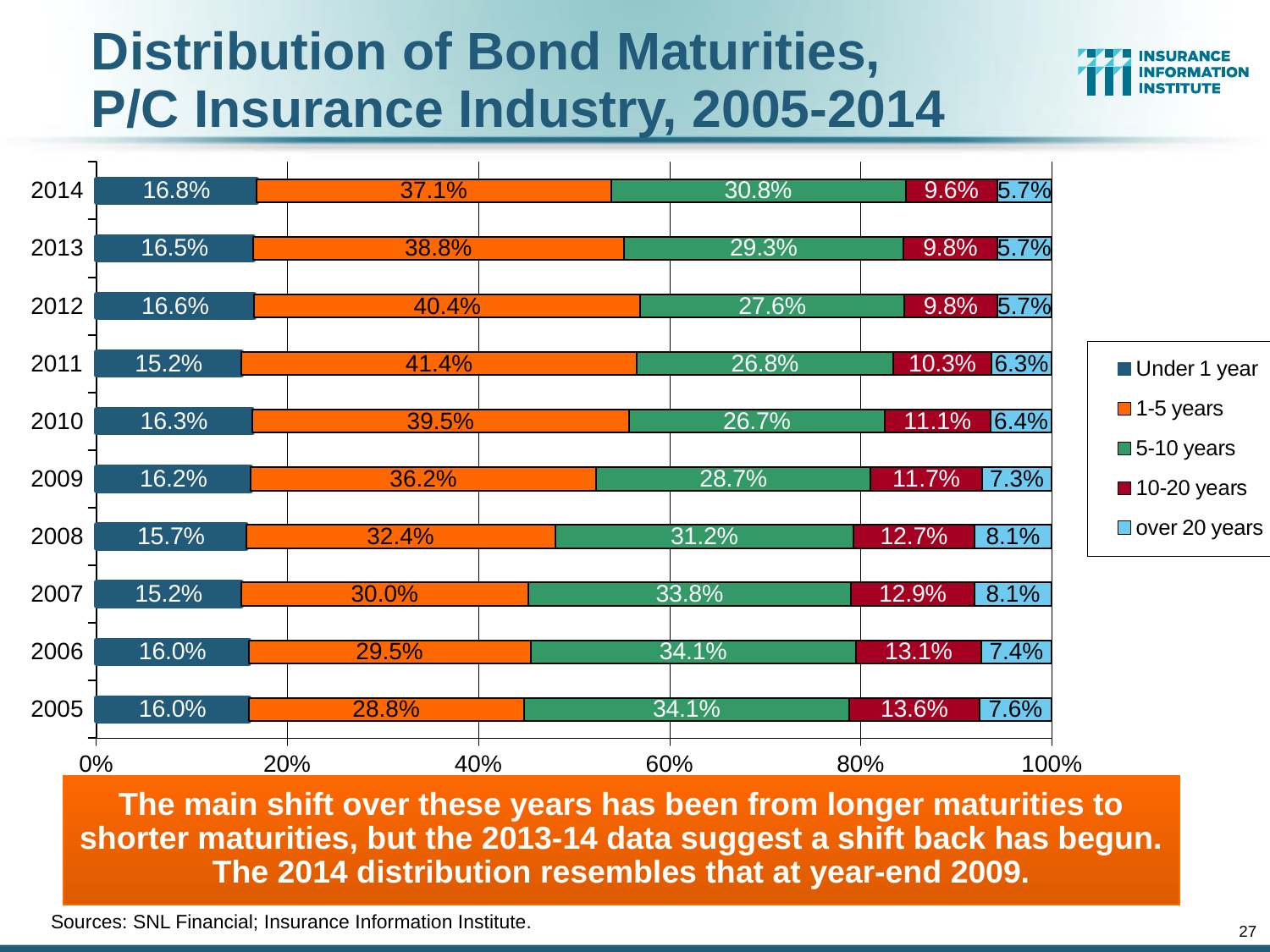
What is the total of the five segments in the 2014 bar? 100.0% How many maturity categories does the legend list? 5 What was the 5-10 years share in 2005? 34.1% What share of bonds had maturities of 1-5 years in 2014? 37.1% By how many percentage points did the 1-5 years share in 2014 exceed that in 2005? 8.3 percentage points Did the share of bonds with 10-20 years maturity rise or fall from 2005 to 2014? Fall Which year had the highest share of bonds in the 1-5 years maturity bucket? 2011 Which maturity category is shown in dark blue in the legend? Under 1 year Which year had a larger 5-10 years share, 2008 or 2009? 2008 Which year had the lowest share of bonds in the 10-20 years maturity bucket? 2014 How many years are shown on the chart? 10 What type of chart is shown on the slide? Stacked bar chart